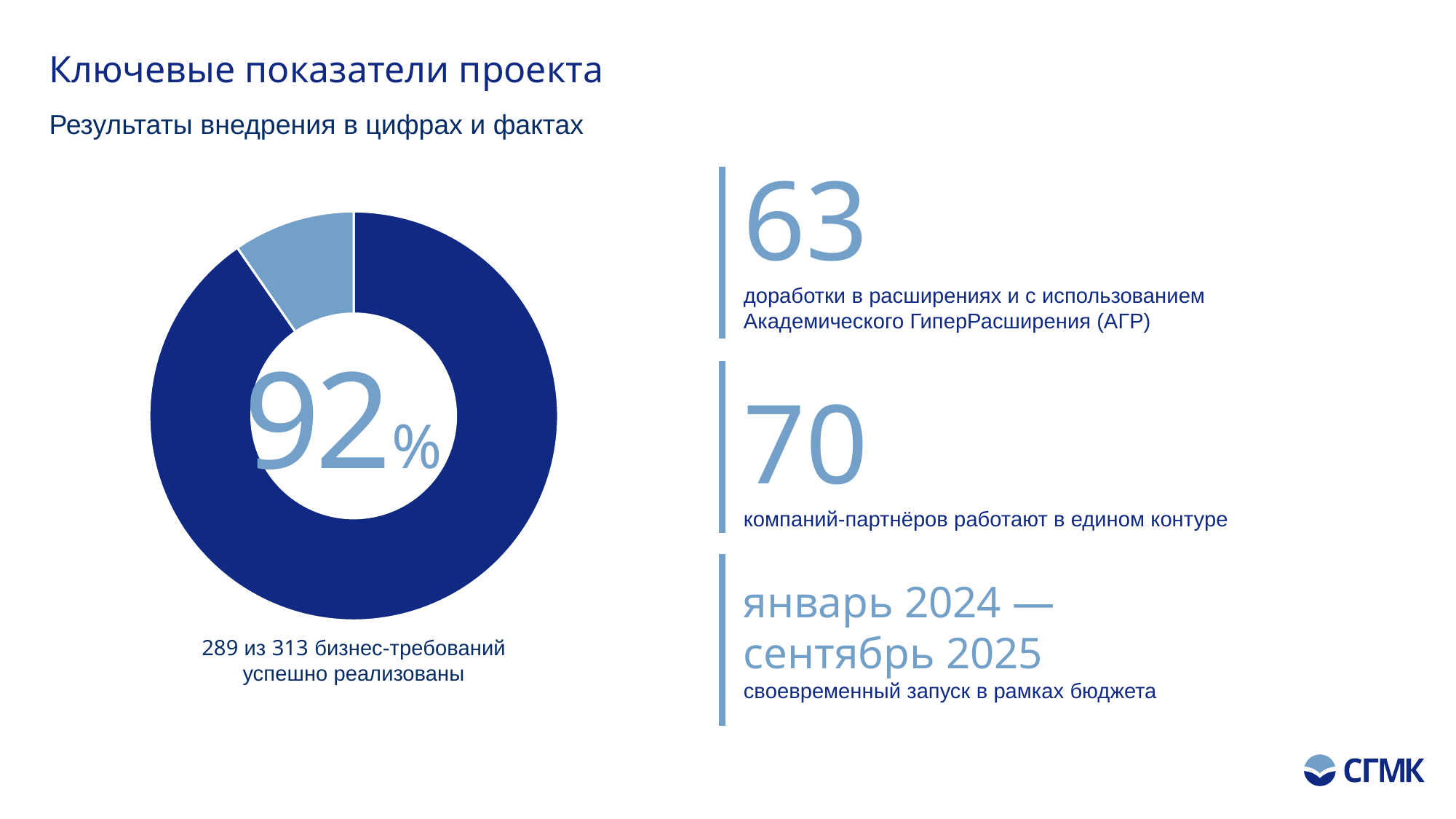
Which slice of the donut chart is larger, the dark blue one or the light blue one? the dark blue one Is the share represented by the dark blue slice of the donut chart greater or less than 50%? greater According to the caption under the donut chart, how many business requirements were successfully implemented? 289 What colour is the largest slice of the donut chart? dark blue Based on the caption under the donut chart, how many of the 313 business requirements were not implemented? 24 What percentage is printed in the centre of the donut chart? 92% What kind of chart is shown on the left of the slide? donut (pie) chart What does the caption under the donut chart say? 289 из 313 бизнес-требований успешно реализованы How many slices does the donut chart have? 2 According to the caption under the donut chart, what is the total number of business requirements? 313